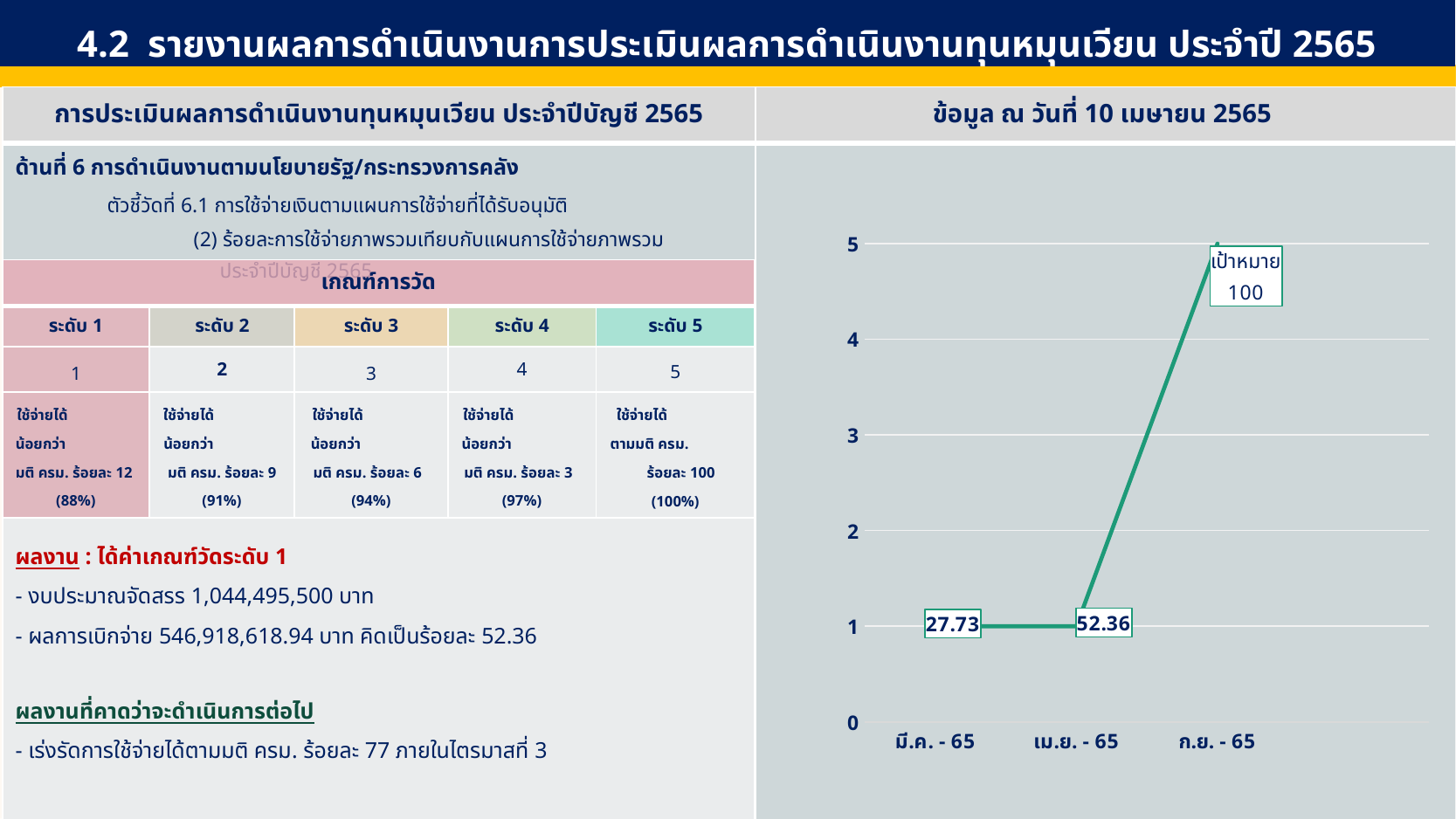
What is the highest tick value shown on the y axis of the line chart? 5 What target value (เป้าหมาย) is labelled for ก.ย. - 65 on the line chart? 100 What is the difference between the labelled values for เม.ย. - 65 and มี.ค. - 65? 24.63 How many data points are plotted on the line chart? 3 What kind of chart is shown on the right side of the slide? line chart Which x-axis category has the highest plotted point on the line chart? ก.ย. - 65 Which is larger on the line chart: the value for มี.ค. - 65 or the value for เม.ย. - 65? เม.ย. - 65 Do the plotted values rise or fall from left to right along the x axis of the line chart? rise What is the value labelled for มี.ค. - 65 on the line chart? 27.73 What are the three x-axis labels on the line chart, from left to right? มี.ค. - 65, เม.ย. - 65, ก.ย. - 65 What is the value labelled for เม.ย. - 65 on the line chart? 52.36